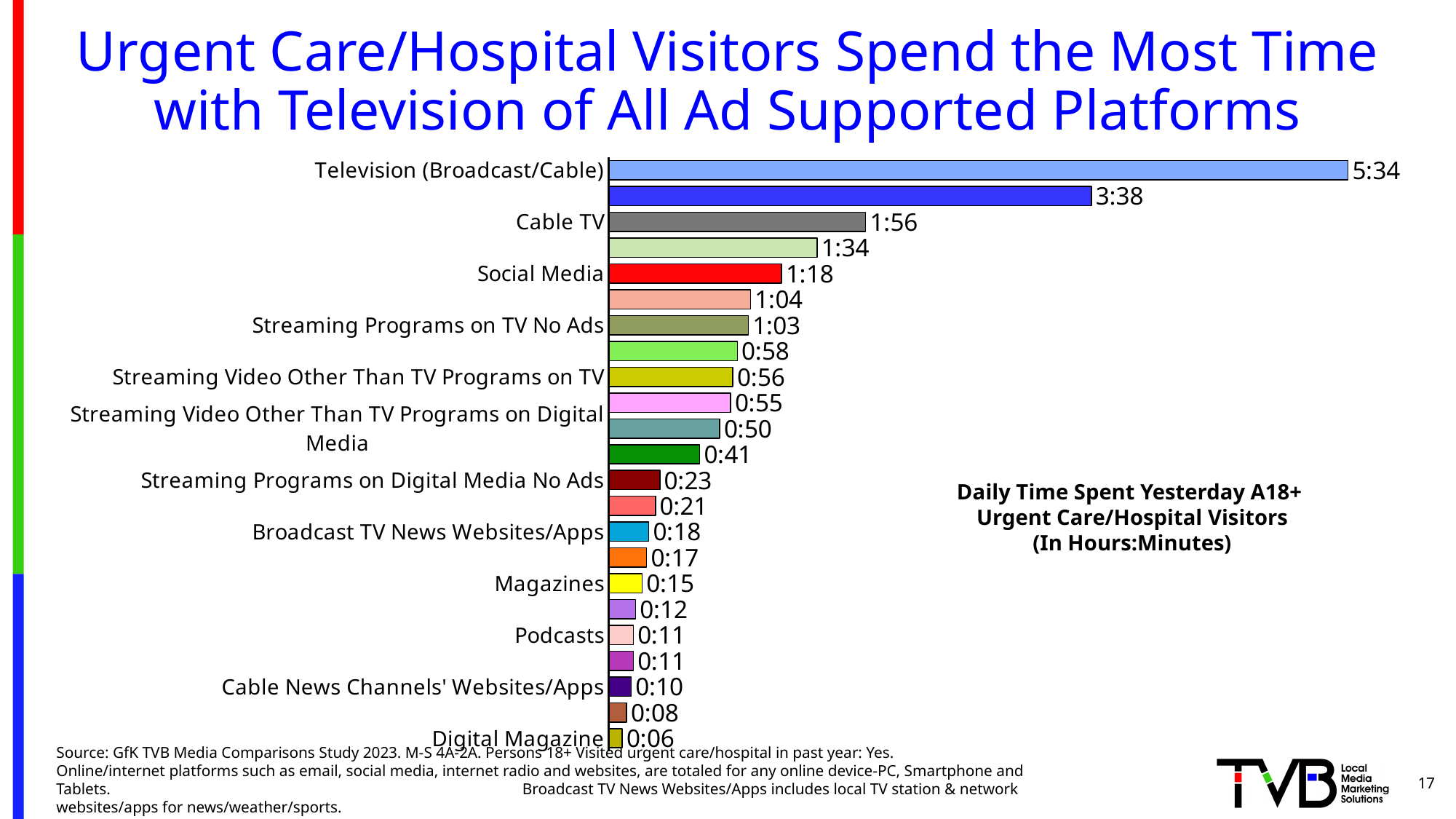
Which has a larger value, Magazines or Podcasts? Magazines What is the daily time spent with Television (Broadcast/Cable) by urgent care/hospital visitors? 5:34 How many bars are plotted in the chart? 23 What type of chart is shown on the slide? Bar chart Which platform has the highest daily time spent? Television (Broadcast/Cable) What is the value shown for Streaming Programs on TV No Ads? 1:03 What is the value shown for Social Media? 1:18 What is the value shown for Broadcast TV News Websites/Apps? 0:18 How much more time is spent with Television (Broadcast/Cable) than with Cable TV? 3:38 Which labeled platform has the lowest daily time spent? Digital Magazine What is the value shown for Digital Magazine? 0:06 What is the value shown for Cable TV? 1:56